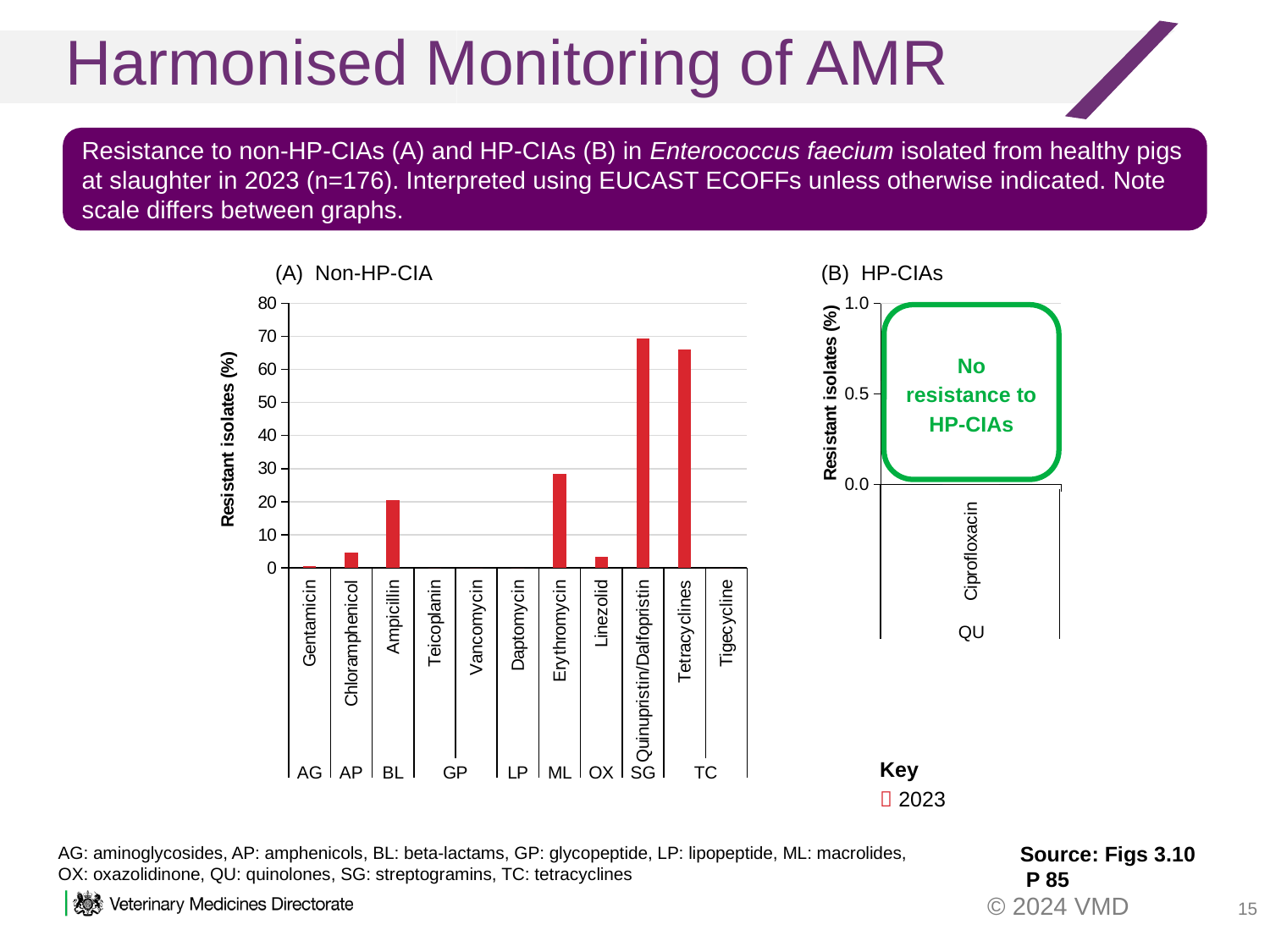
In chart (A) Non-HP-CIA, is the value for Chloramphenicol greater or less than 10? less What kind of chart is chart (A) Non-HP-CIA? Bar chart In chart (A) Non-HP-CIA, is the value for Erythromycin greater or less than 20? greater How many antibiotics are shown on the x axis of chart (A) Non-HP-CIA? 11 In chart (A) Non-HP-CIA, which antibiotic has the highest percentage of resistant isolates? Quinupristin/Dalfopristin In chart (A) Non-HP-CIA, is the value for Ampicillin greater or less than 30? less In chart (A) Non-HP-CIA, which has a higher percentage of resistant isolates, Linezolid or Chloramphenicol? Chloramphenicol In chart (A) Non-HP-CIA, which has a higher percentage of resistant isolates, Erythromycin or Ampicillin? Erythromycin What does the annotation box in chart (B) HP-CIAs say? No resistance to HP-CIAs How many antibiotics are shown on the x axis of chart (B) HP-CIAs? 1 How many series does the key list for the charts? 1